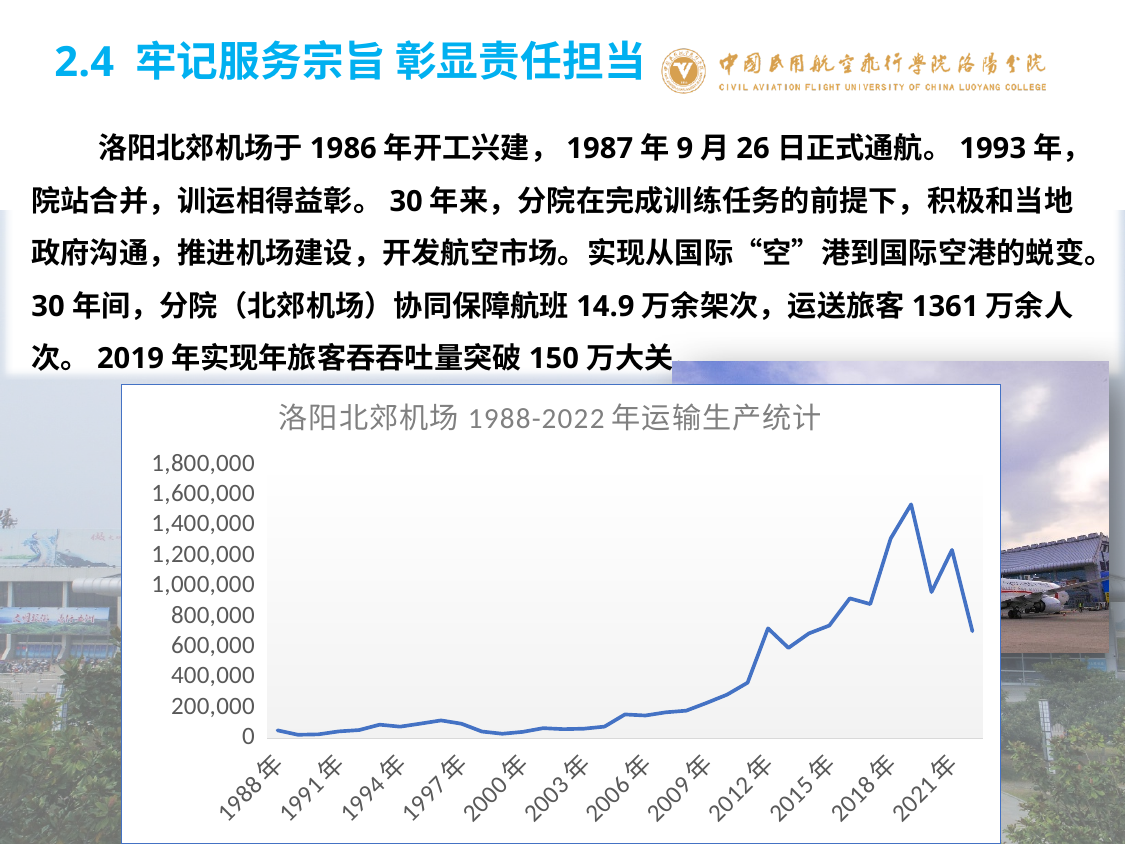
Is the value for 2012年 greater or less than 400,000? greater Is the value for 1988年 greater or less than 200,000? less In which year does the line reach its highest value? 2019年 Does the value rise or fall from 2019年 to 2020年? fall What kind of chart is shown on the slide? line chart Is the value for 2019年 greater or less than 1,400,000? greater How many year labels are shown on the x axis? 12 Which year has the larger value, 2015年 or 2021年? 2021年 Which year has the larger value, 2019年 or 2021年? 2019年 Does the line generally rise or fall from 1988年 to 2019年? rise What is the title of the chart? 洛阳北郊机场 1988-2022 年运输生产统计